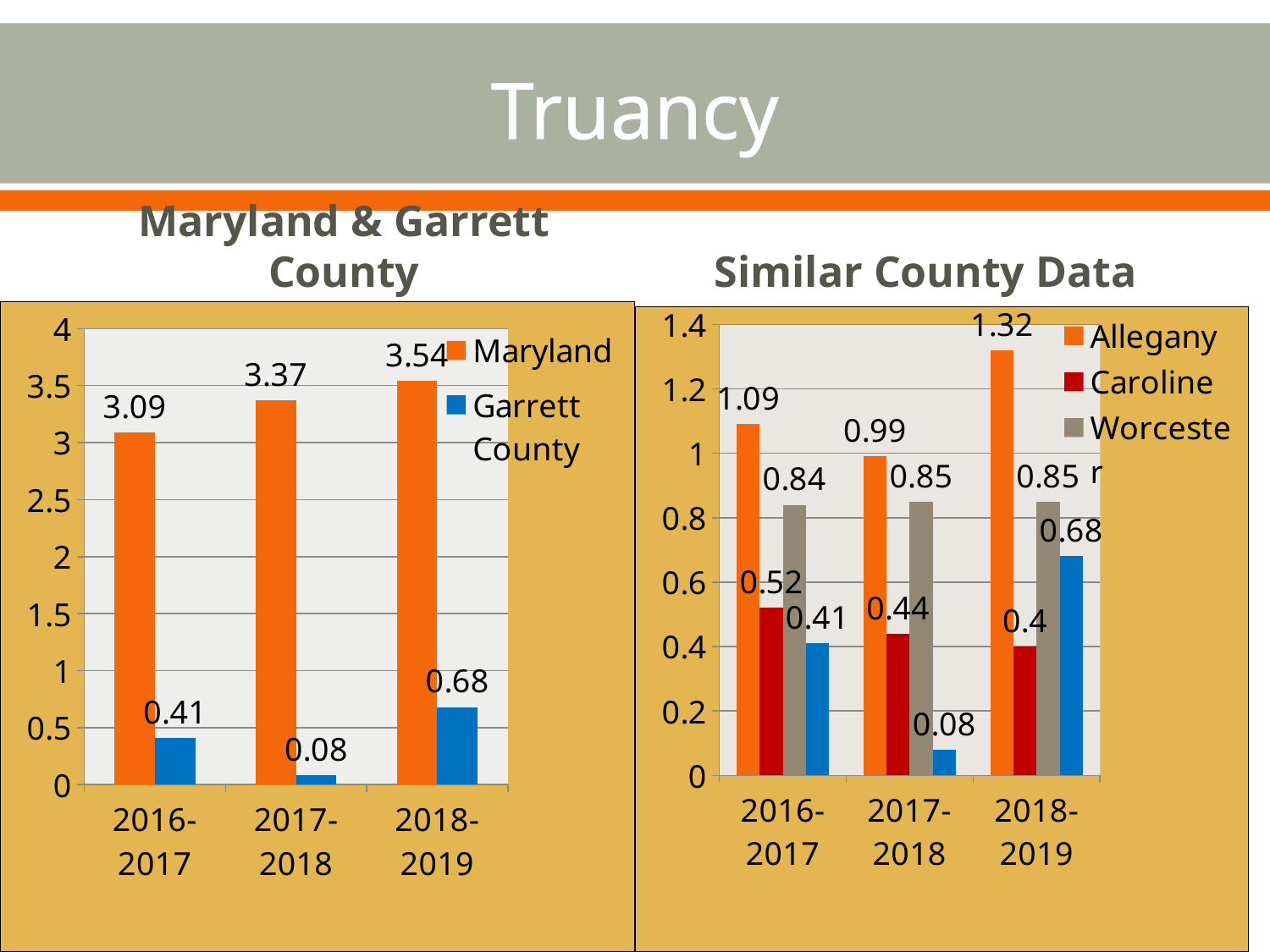
In the Maryland & Garrett County chart, how many series does the legend list? 2 In the Similar County Data chart, which year has the highest Allegany value? 2018-2019 In the Maryland & Garrett County chart, what is the value for Maryland in 2017-2018? 3.37 In the Maryland & Garrett County chart, do the Maryland values rise or fall from 2016-2017 to 2018-2019? rise In the Similar County Data chart, what is the difference between the Allegany and Caroline values in 2016-2017? 0.57 In the Maryland & Garrett County chart, what is the value for Garrett County in 2018-2019? 0.68 In the Maryland & Garrett County chart, what is the difference between the Maryland values for 2018-2019 and 2016-2017? 0.45 What kind of chart is the Similar County Data chart? bar chart In the Similar County Data chart, which is larger in 2016-2017, Caroline or Worcester? Worcester In the Maryland & Garrett County chart, which year has the lowest Garrett County value? 2017-2018 In the Similar County Data chart, what is the value for Allegany in 2018-2019? 1.32 In the Similar County Data chart, what is the value for Caroline in 2017-2018? 0.44